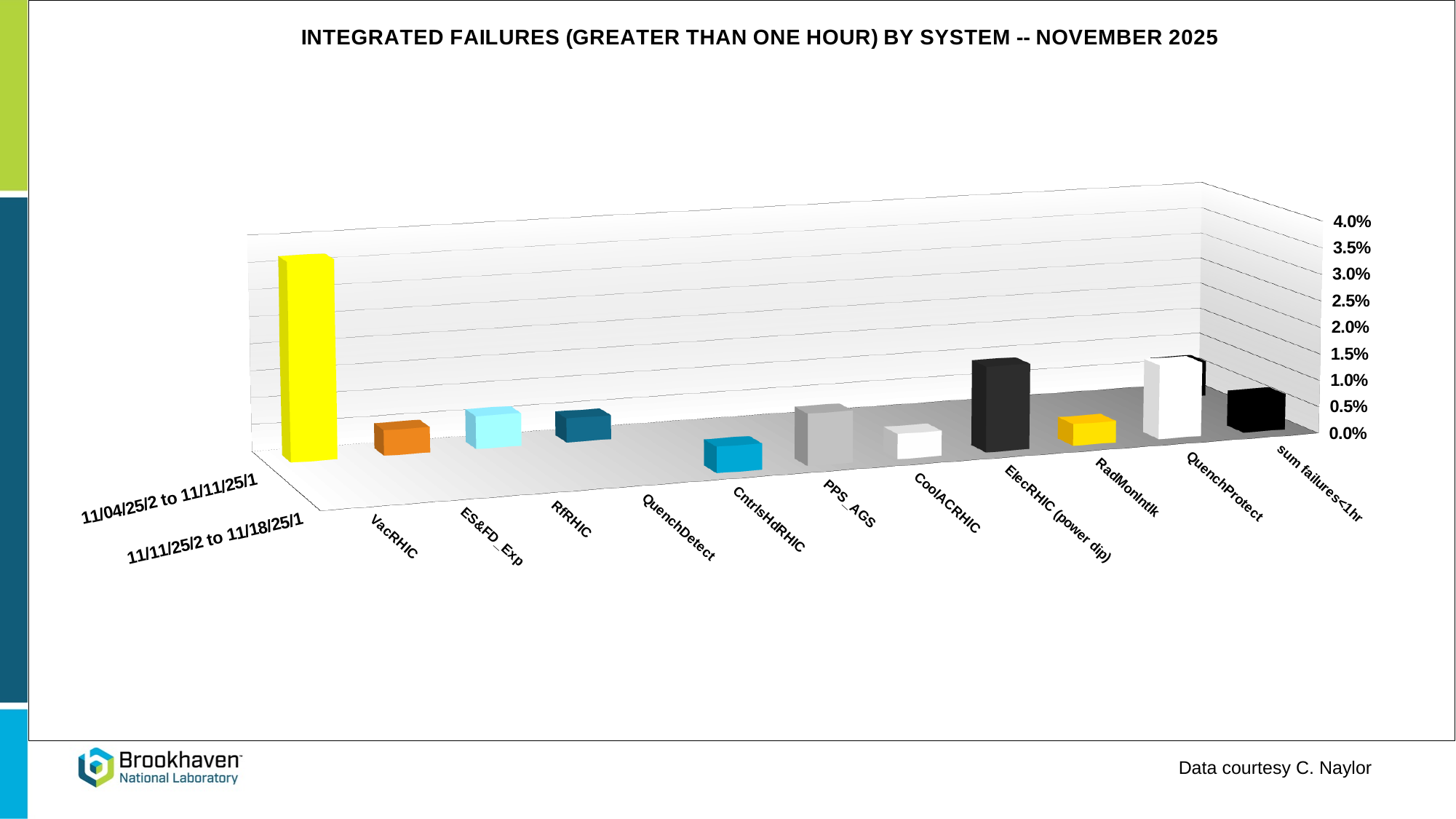
How many system categories are plotted along the category axis? 11 Is the value for ElecRHIC (power dip) greater or less than 2.0%? less What is the highest value shown on the percentage axis? 4.0% Which is larger, the bar for ElecRHIC (power dip) or the bar for ES&FD_Exp? ElecRHIC (power dip) What kind of chart is shown on the slide? bar chart Is the value for RadMonIntlk greater or less than 1.5%? less What is the title of the chart? INTEGRATED FAILURES (GREATER THAN ONE HOUR) BY SYSTEM -- NOVEMBER 2025 Is the value for ES&FD_Exp greater or less than 1.0%? less Which system has the highest bar? VacRHIC Which is larger, the bar for VacRHIC or the bar for ElecRHIC (power dip)? VacRHIC